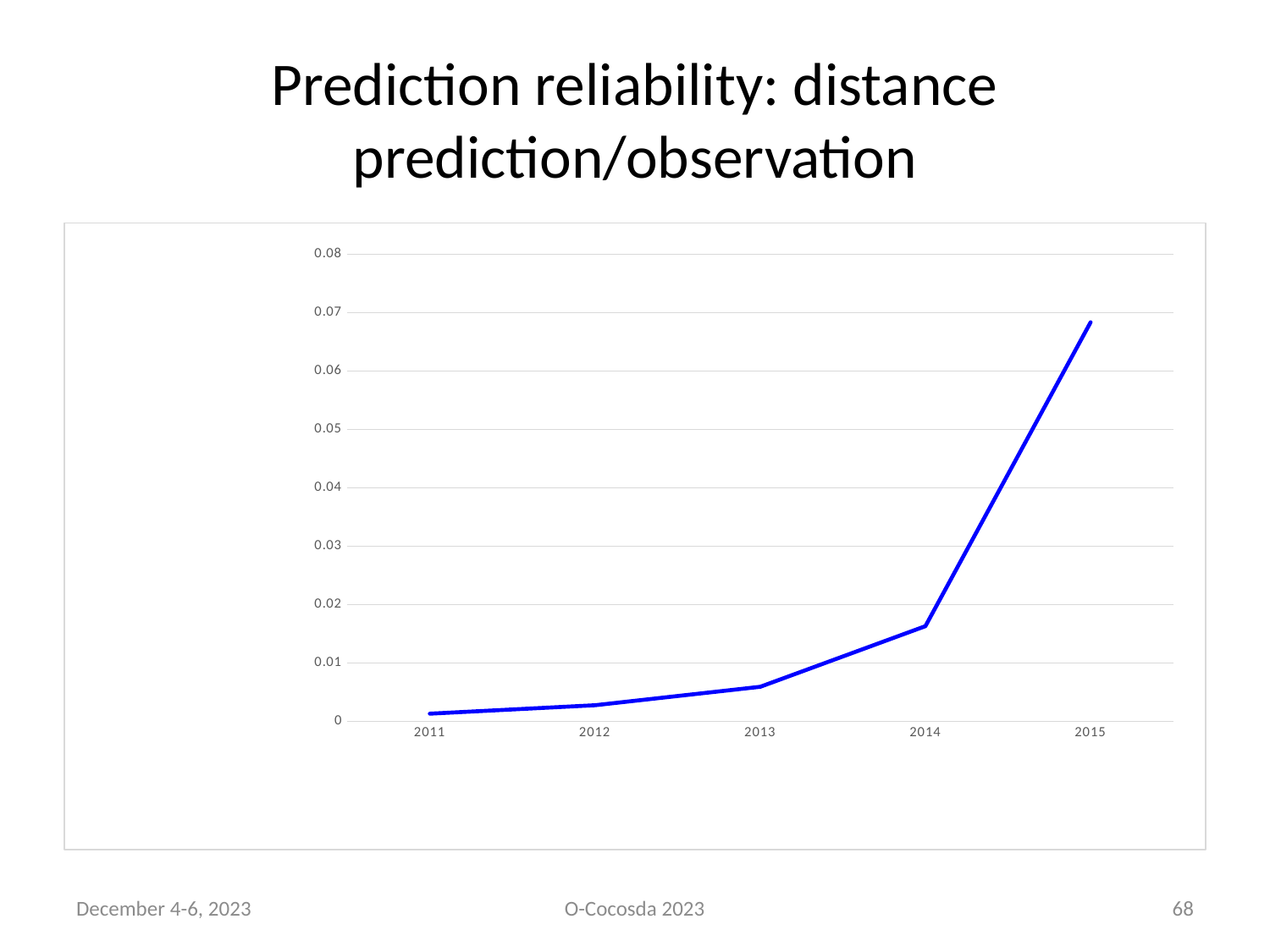
Which is larger, the value for 2014 or the value for 2015? 2015 Which year has the lowest value? 2011 Is the value for 2013 greater or less than 0.01? less Which is larger, the value for 2013 or the value for 2014? 2014 Is the value for 2014 greater or less than 0.02? less How many years are plotted along the x axis? 5 What kind of chart is shown on the slide? line chart Do the values rise or fall from 2011 to 2015? rise Is the value for 2015 greater or less than 0.06? greater What is the first year shown on the x axis? 2011 Which year has the highest value? 2015